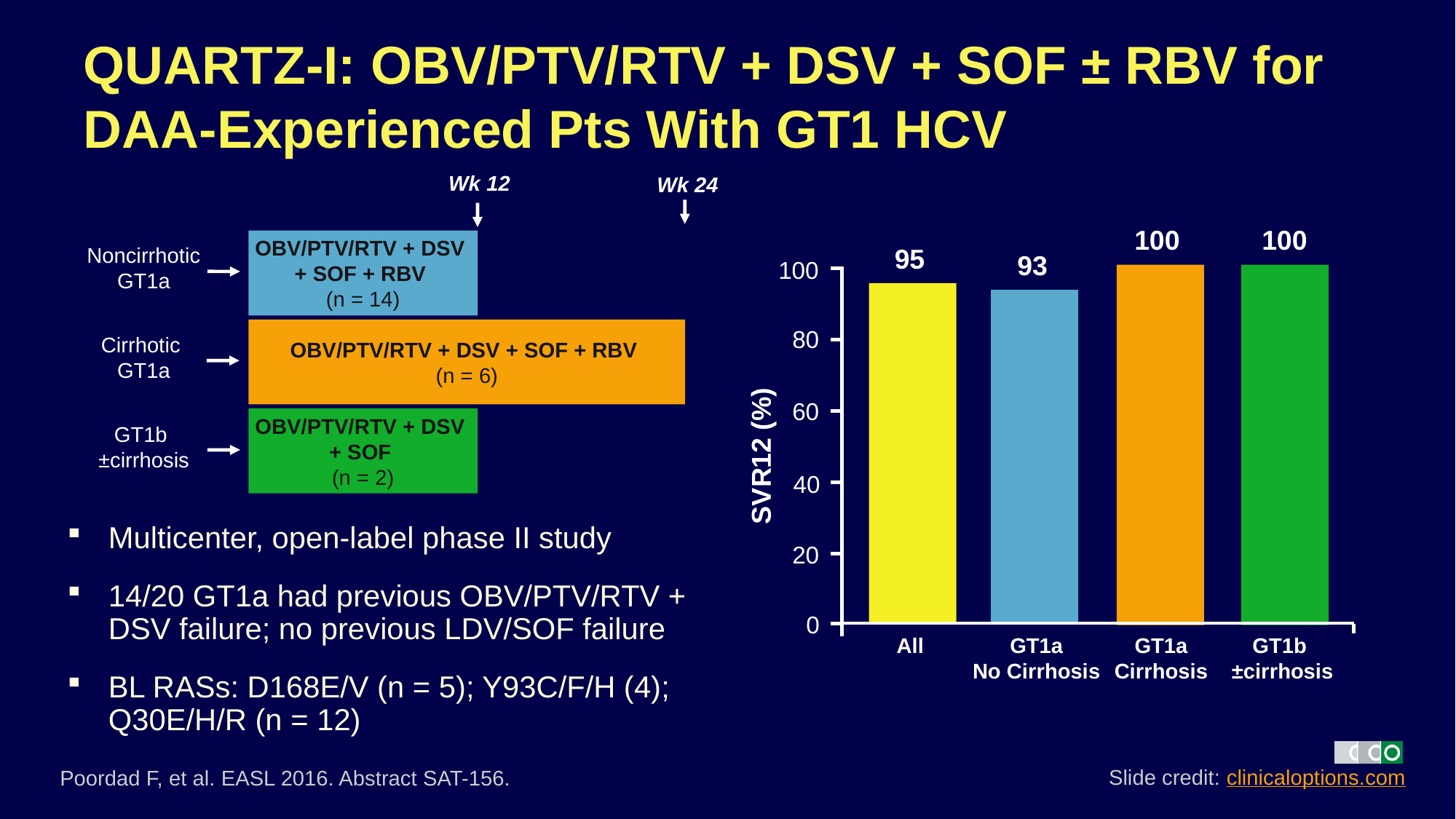
What is the SVR12 value for the All group? 95 How many categories are shown on the x axis of the chart? 4 What is the SVR12 value for GT1a No Cirrhosis? 93 What is the label of the y axis of the chart? SVR12 (%) What is the SVR12 value for GT1b ±cirrhosis? 100 Which is larger, the SVR12 for GT1a Cirrhosis or for GT1a No Cirrhosis? GT1a Cirrhosis What is the SVR12 value for GT1a Cirrhosis? 100 Is the SVR12 value for GT1a No Cirrhosis greater or less than 80? greater What is the difference in SVR12 between the All group and GT1a No Cirrhosis? 2 What kind of chart is shown on the slide? Bar chart Which category has the lowest SVR12 value? GT1a No Cirrhosis What is the difference in SVR12 between GT1a Cirrhosis and GT1a No Cirrhosis? 7